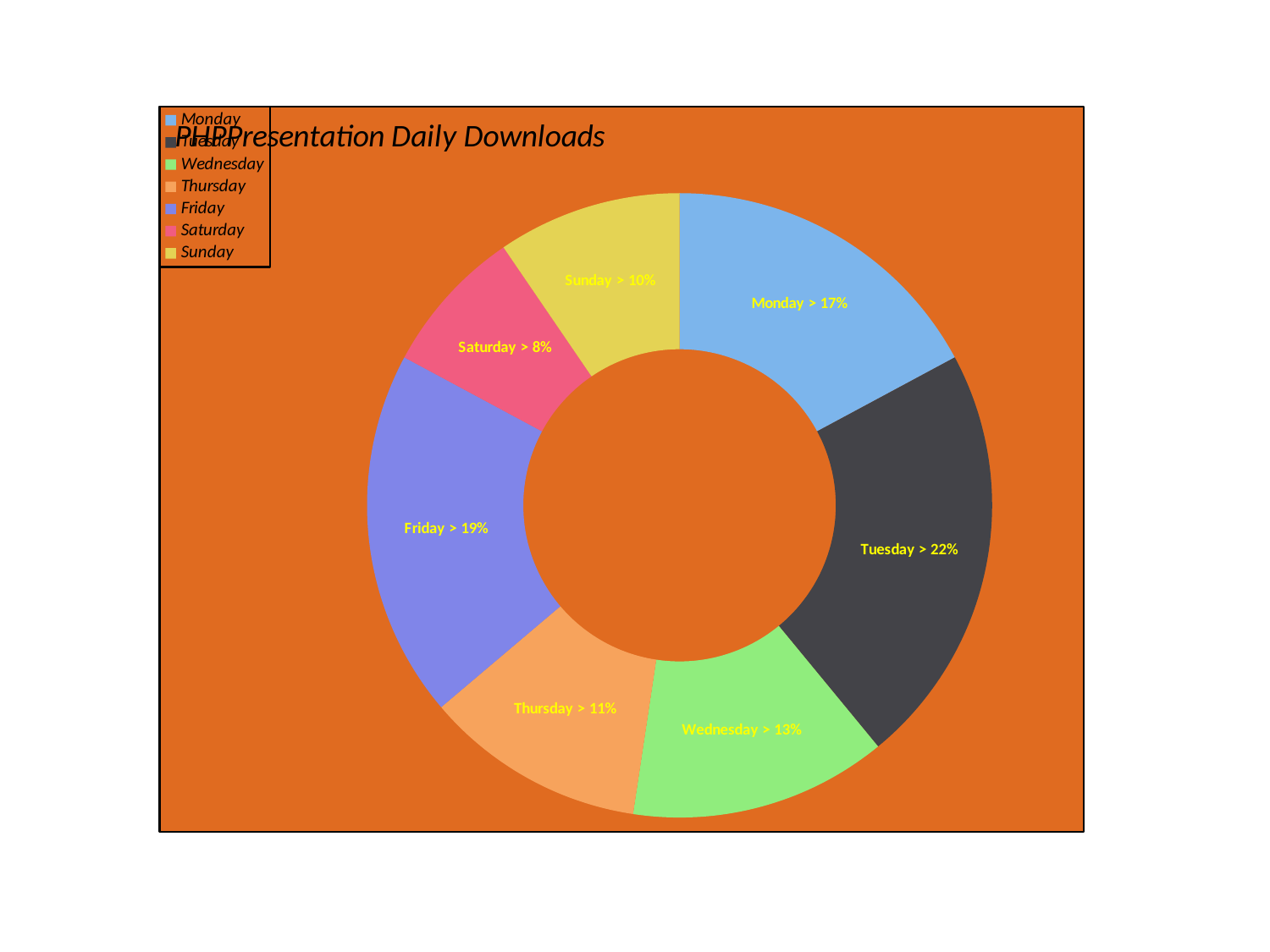
What share of daily downloads does Tuesday account for? 22% What colour is the Friday segment? Purple/blue What kind of chart is shown on the slide? Doughnut (pie) chart Which day has the largest share of downloads? Tuesday Which has a larger share, Thursday or Sunday? Thursday What is the title of the chart? PHPPresentation Daily Downloads Which day has the smallest share of downloads? Saturday How many days are shown in the chart? 7 What share of daily downloads does Wednesday account for? 13% What share of daily downloads does Friday account for? 19% What is the difference in percentage points between Tuesday's and Monday's shares? 5 What share of daily downloads does Saturday account for? 8%